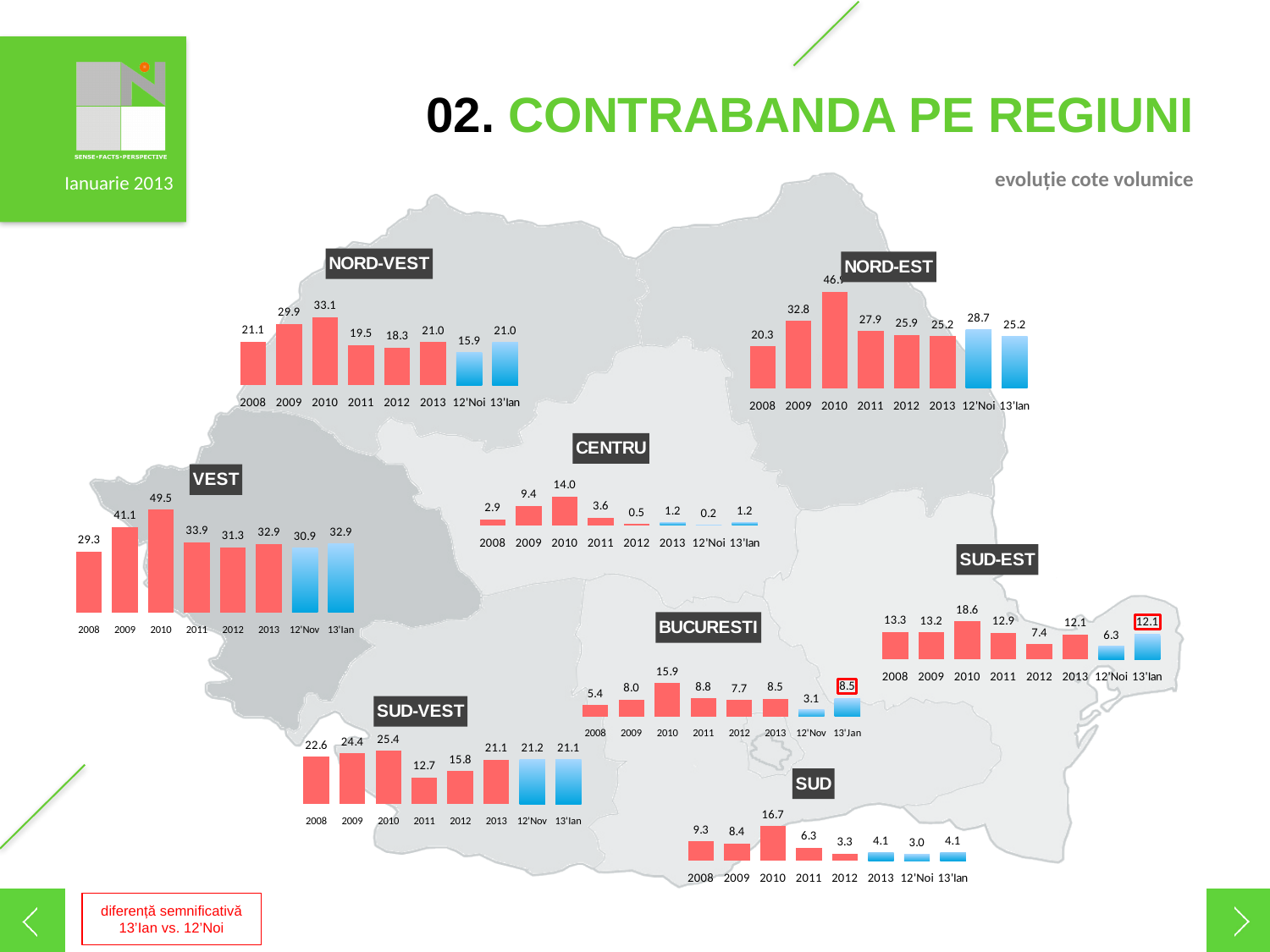
In the BUCURESTI chart, which is larger, the value for 2010 or the value for 2011? 2010 In the NORD-VEST chart, what is the difference between the 2009 value and the 2008 value? 8.8 In the SUD-VEST chart, which year has the lowest value? 2011 What is the main title of the slide? 02. CONTRABANDA PE REGIUNI In the CENTRU chart, do the values rise or fall from 2010 to 2012? Fall How many bars are shown in the NORD-EST chart? 8 In the SUD chart, what is the value for 2010? 16.7 In the SUD-EST chart, what is the difference between the 13'Ian value and the 12'Noi value? 5.8 In the VEST chart, which year has the highest value? 2010 In the NORD-VEST chart, what is the value for 2010? 33.1 In the CENTRU chart, what is the value for 12'Noi? 0.2 What type of chart is used for each region on the slide? Bar chart